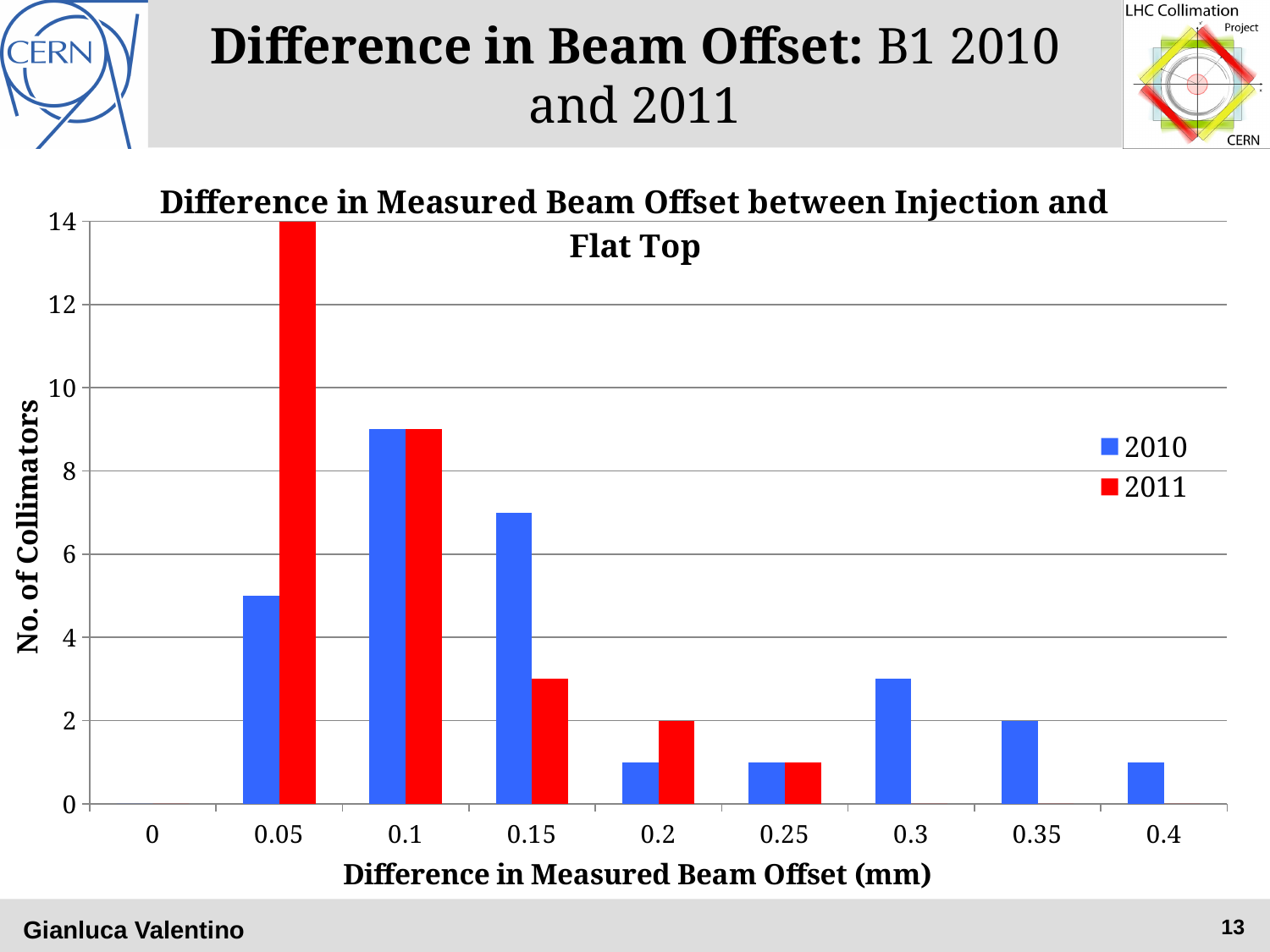
Which colour represents the 2011 series in the legend? red At which difference in measured beam offset does the 2010 series reach its highest value? 0.1 What type of chart is shown on the slide? bar chart What is the number of collimators for 2011 at a difference of 0.05 mm? 14 How many series does the legend list? 2 What is the number of collimators for 2011 at a difference of 0.2 mm? 2 How many categories are shown along the x axis? 9 At a difference of 0.15 mm, which series has the larger number of collimators, 2010 or 2011? 2010 What is the number of collimators for 2010 at a difference of 0.35 mm? 2 What is the difference between the 2011 values at 0.05 mm and 0.2 mm? 12 At which difference in measured beam offset does the 2011 series reach its highest value? 0.05 Is the value for 2010 at a difference of 0.15 mm greater or less than 6? greater